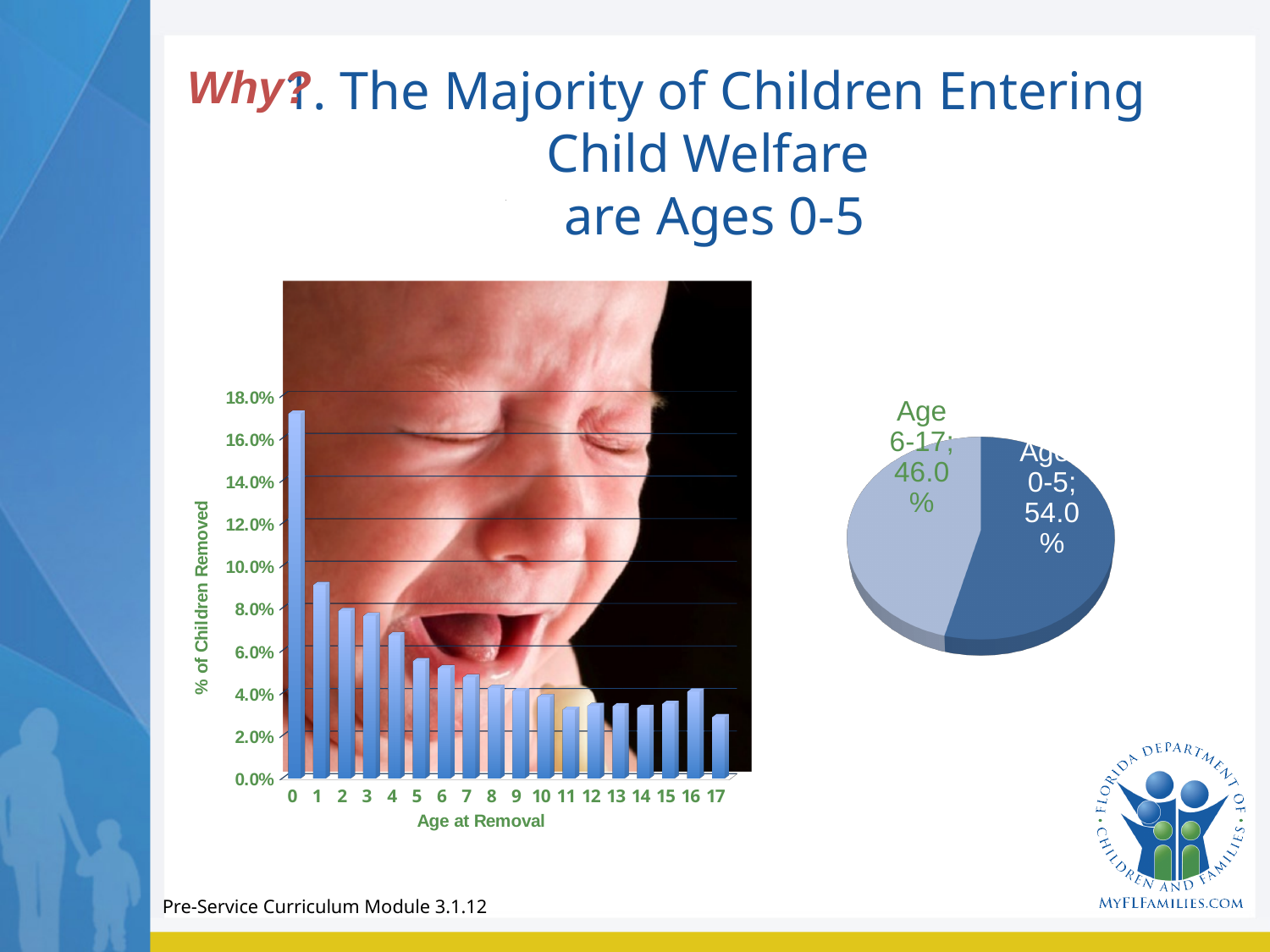
What is the label on the y axis of the bar chart on the left? % of Children Removed In the bar chart on the left, do the percentages generally rise or fall as age at removal increases? fall What kind of chart is the chart on the left showing % of Children Removed by Age at Removal? bar chart In the bar chart on the left, which age at removal has the highest percentage of children removed? 0 In the pie chart on the right, what is the difference between the Age 0-5 share and the Age 6-17 share? 8.0% In the pie chart on the right, which slice is larger, Age 0-5 or Age 6-17? Age 0-5 How many slices does the pie chart on the right have? 2 In the bar chart on the left, is the value for age 0 greater or less than 16.0%? greater In the pie chart on the right, what share is shown for Age 6-17? 46.0% In the bar chart on the left, how many age categories are shown on the x axis? 18 In the pie chart on the right, what share is shown for Age 0-5? 54.0% In the bar chart on the left, is the value for age 1 greater or less than 10.0%? less